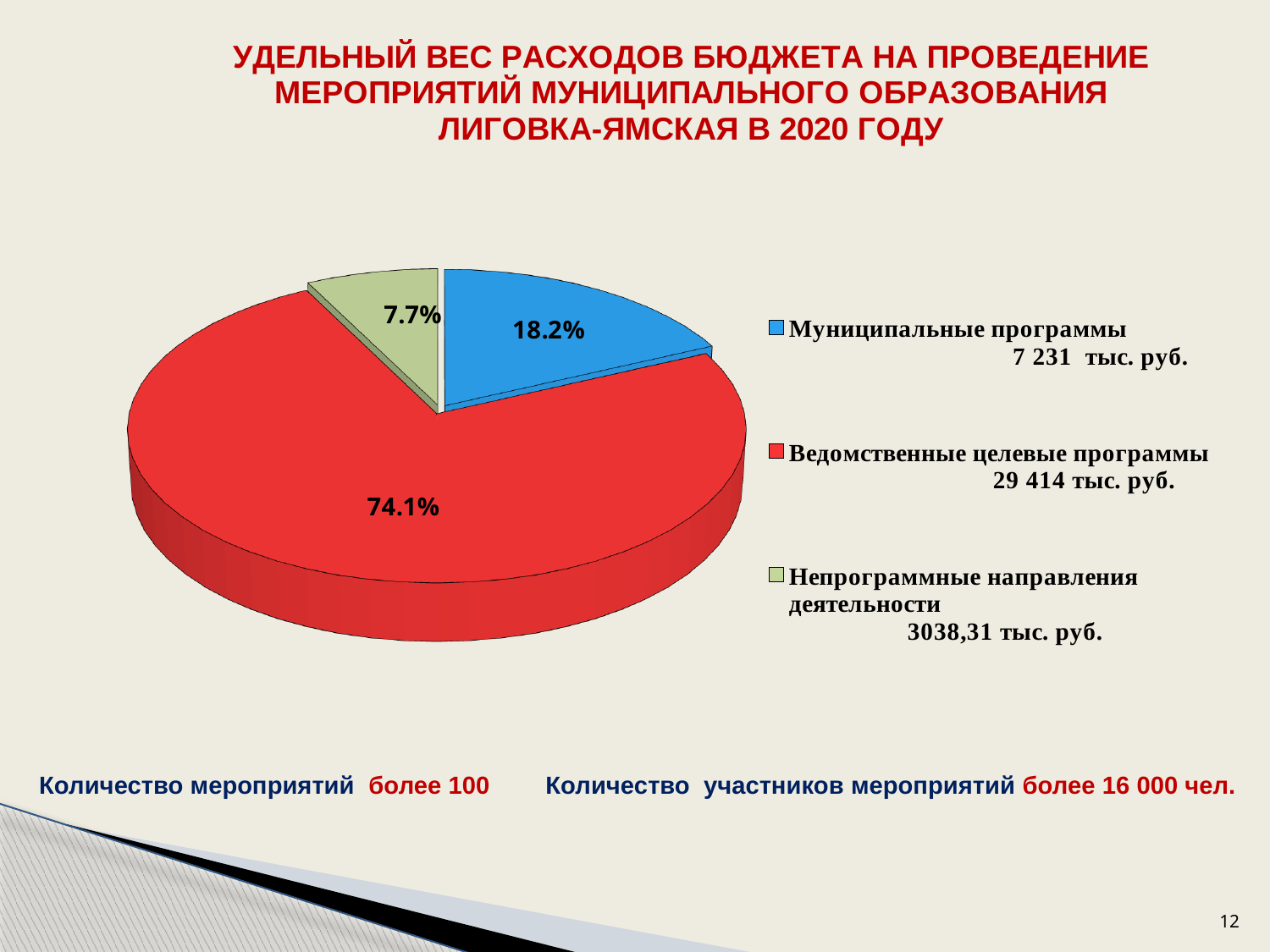
What amount in тыс. руб. is shown in the legend for Ведомственные целевые программы? 29 414 тыс. руб. Which colour represents Муниципальные программы in the pie chart? Blue How many entries does the legend list? 3 How many slices does the pie chart have? 3 What share of the pie does Непрограммные направления деятельности represent? 7.7% What share of the pie does Муниципальные программы represent? 18.2% What share of the pie does Ведомственные целевые программы represent? 74.1% What kind of chart is shown on the slide? Pie chart What amount in тыс. руб. is shown in the legend for Муниципальные программы? 7 231 тыс. руб. Which category has the largest share of the pie? Ведомственные целевые программы What is the difference in percentage points between the shares of Ведомственные целевые программы and Муниципальные программы? 55.9 Which category has the smallest share of the pie? Непрограммные направления деятельности